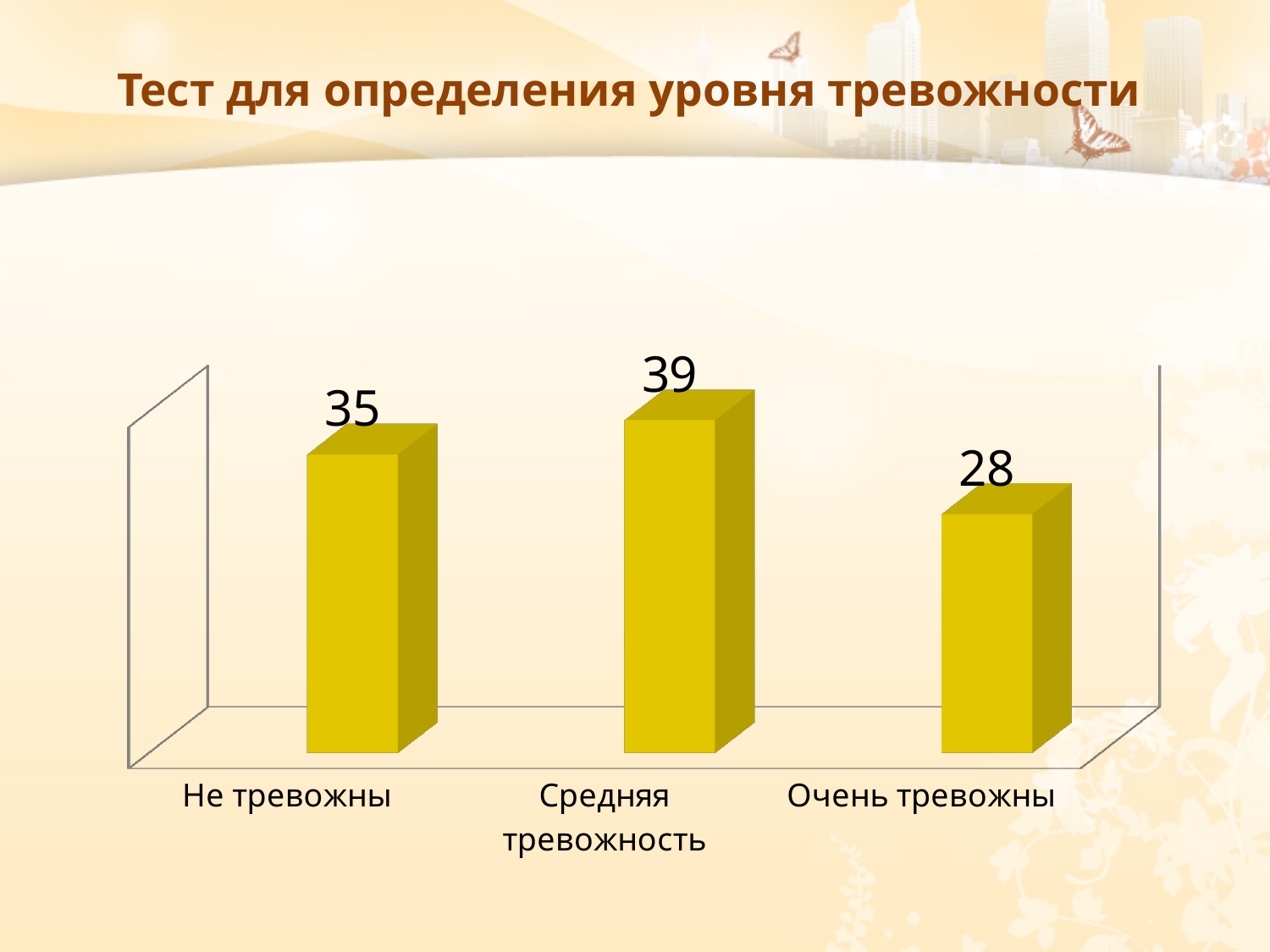
What is the value for "Средняя тревожность"? 39 What is the difference between the values for "Средняя тревожность" and "Очень тревожны"? 11 How many categories are shown in the chart? 3 Which category has the lowest value? Очень тревожны What kind of chart is shown on the slide? bar chart Which is larger, the value for "Не тревожны" or the value for "Очень тревожны"? Не тревожны What is the value for "Очень тревожны"? 28 What is the title of the slide? Тест для определения уровня тревожности What is the total of the three values shown in the chart? 102 What is the value for "Не тревожны"? 35 What is the difference between the values for "Не тревожны" and "Средняя тревожность"? 4 Which category has the highest value? Средняя тревожность